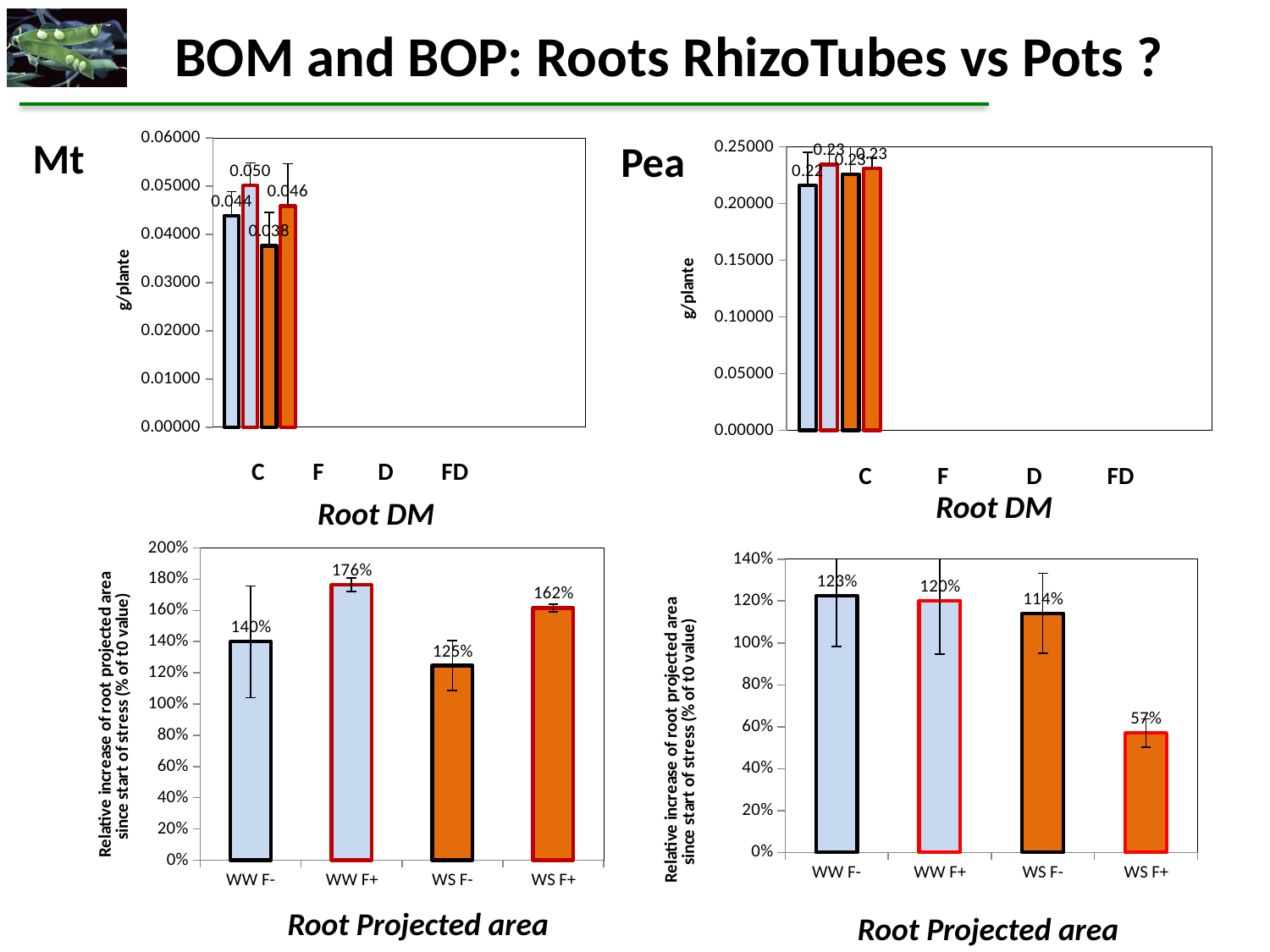
In the top-left 'Root DM' chart (Mt), which category has the highest value? F In the bottom-left 'Root Projected area' chart (Mt), what is the value for WS F-? 125% In the bottom-left 'Root Projected area' chart (Mt), what is the difference between the WW F+ and WS F+ values? 14% In the bottom-left 'Root Projected area' chart (Mt), what is the value for WW F+? 176% In the bottom-right 'Root Projected area' chart (Pea), which category has the lowest value? WS F+ In the bottom-left 'Root Projected area' chart (Mt), which category has the highest value? WW F+ In the bottom-right 'Root Projected area' chart (Pea), what is the value for WS F+? 57% What type of chart is the bottom-right 'Root Projected area' chart (Pea)? Bar chart In the bottom-left 'Root Projected area' chart (Mt), how many bars are plotted? 4 In the top-left 'Root DM' chart (Mt), what is the value for D? 0.038 In the bottom-right 'Root Projected area' chart (Pea), what is the value for WW F-? 123% In the bottom-right 'Root Projected area' chart (Pea), what is the difference between the WS F- and WS F+ values? 57%